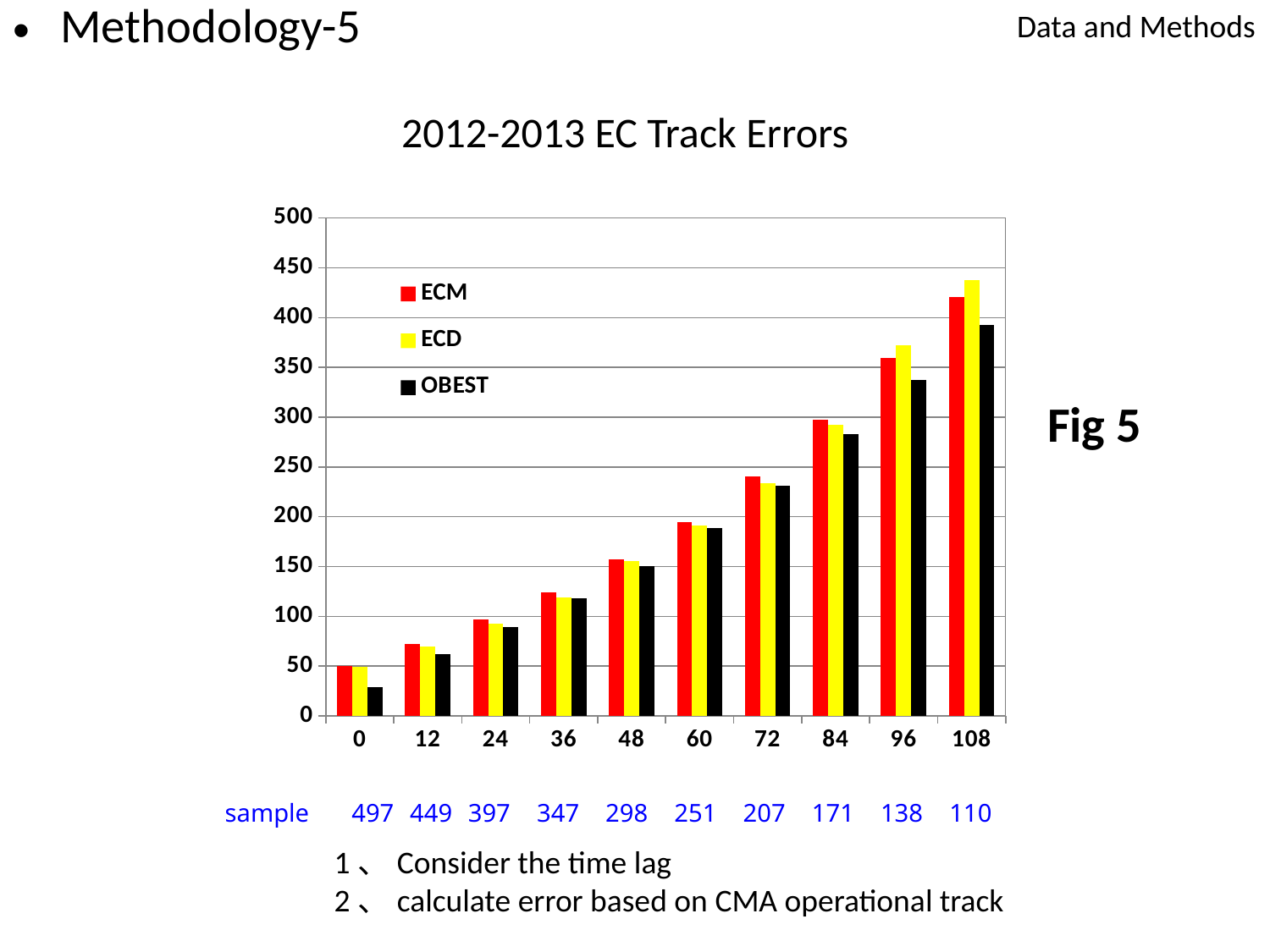
At which x-axis category is the ECM value highest? 108 How many categories are shown on the x axis? 10 Is the OBEST value at category 0 greater or less than 50? less What is the title of the chart? 2012-2013 EC Track Errors What kind of chart is shown on the slide? bar chart At which x-axis category is the OBEST value lowest? 0 Do the ECM values rise or fall as the x-axis values increase from 0 to 108? rise Is the ECD value at category 96 greater or less than 350? greater At category 108, which series has the larger value, ECD or OBEST? ECD How many series does the legend list? 3 Is the ECM value at category 108 greater or less than 400? greater